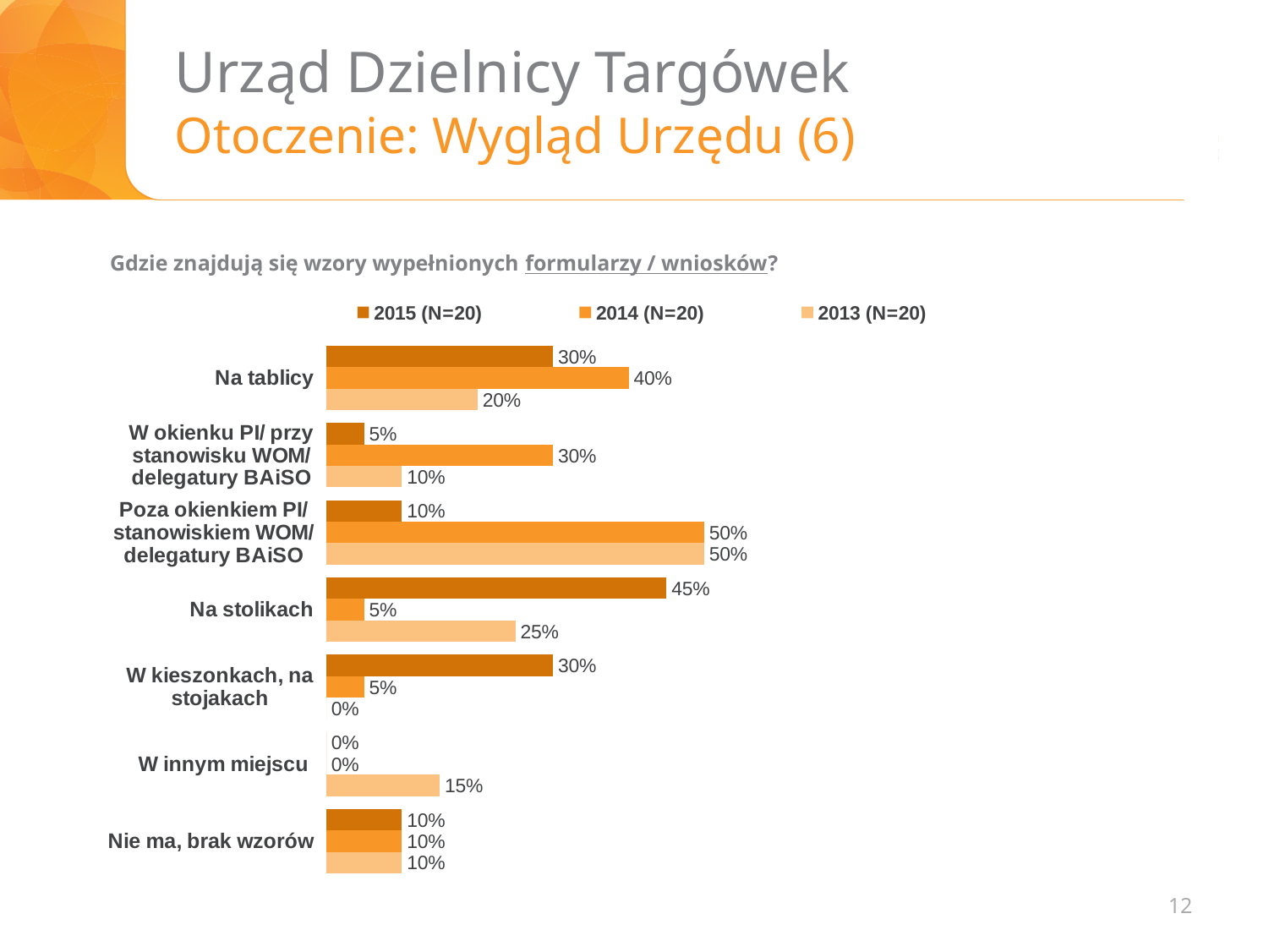
Which is larger for "Na stolikach": the 2015 (N=20) value or the 2013 (N=20) value? 2015 (N=20) What is the difference between the 2014 and 2015 values for "W okienku PI/ przy stanowisku WOM/ delegatury BAiSO"? 25% What is the value for "Na tablicy" in the 2014 (N=20) series? 40% What is the value for "W innym miejscu" in the 2013 (N=20) series? 15% Which category has the highest value in the 2015 (N=20) series? Na stolikach What kind of chart is shown on the slide? Bar chart What is the value for "Na stolikach" in the 2015 (N=20) series? 45% What is the value for "Nie ma, brak wzorów" in the 2013 (N=20) series? 10% How many categories are shown on the chart? 7 Which category has the lowest value in the 2013 (N=20) series? W kieszonkach, na stojakach What question does the chart answer, as stated above it? Gdzie znajdują się wzory wypełnionych formularzy / wniosków? How many series does the legend list? 3